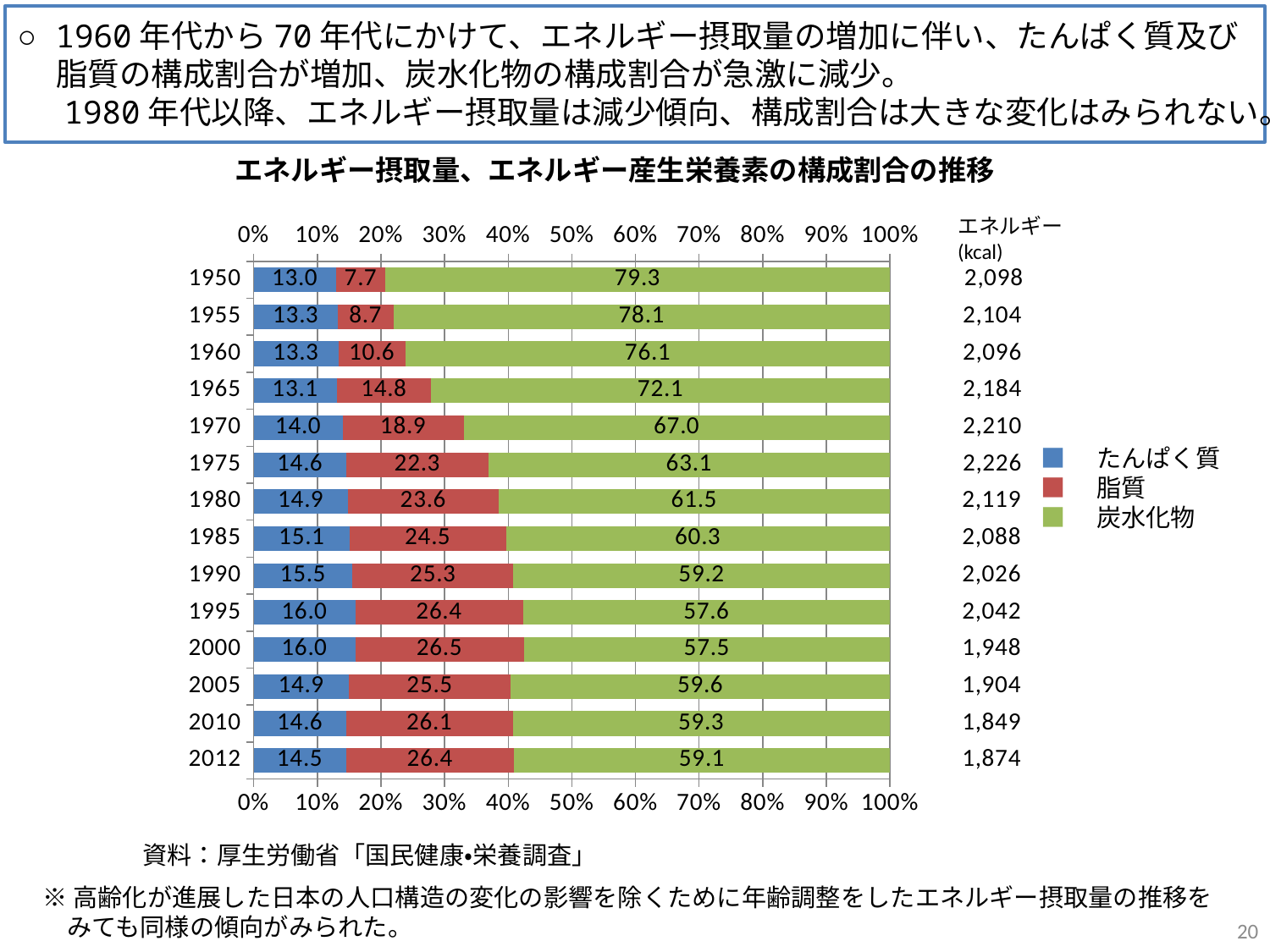
What kind of chart is shown on the slide? Stacked bar chart Which year has the lowest たんぱく質 share? 1950 How many years are shown on the chart? 14 Does the 脂質 share rise or fall from 1950 to 2000? Rise Which year has the highest 炭水化物 share? 1950 What is the difference between the 炭水化物 share in 1950 and in 2012? 20.2 What is the 炭水化物 share for 1950? 79.3 What is the total of the stacked bar for 1950? 100.0 In 1965, which is larger: the たんぱく質 share or the 脂質 share? 脂質 What is the エネルギー (kcal) value shown for 1975? 2,226 How many series does the legend list? 3 What is the 脂質 share for 1970? 18.9